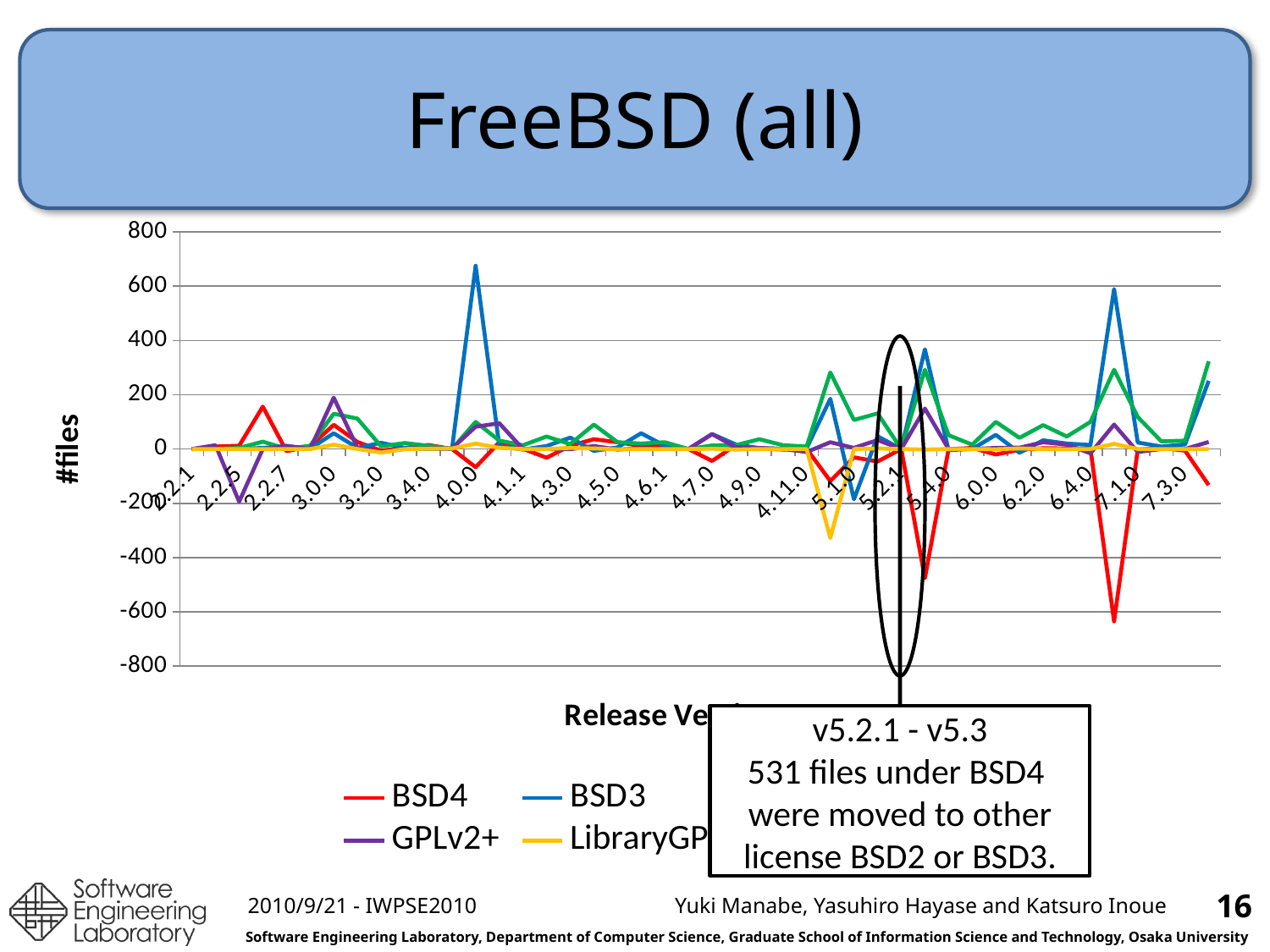
Which series reaches the lowest value anywhere on the chart? BSD4 What kind of chart is shown on the slide? line chart Is the peak value of BSD3 near release 4.0.0 greater or less than 600? greater What is the label of the vertical axis? #files What is the highest value shown on the vertical axis? 800 Which series reaches the highest value anywhere on the chart? BSD3 Is the value of BSD3 near release 5.3 greater or less than 200? greater Is the value of BSD4 near release 5.3 greater or less than -400? less Which is larger: the BSD3 peak near release 4.0.0 or the BSD3 peak near release 7.1.0? the peak near 4.0.0 What is the title of the chart? FreeBSD (all)